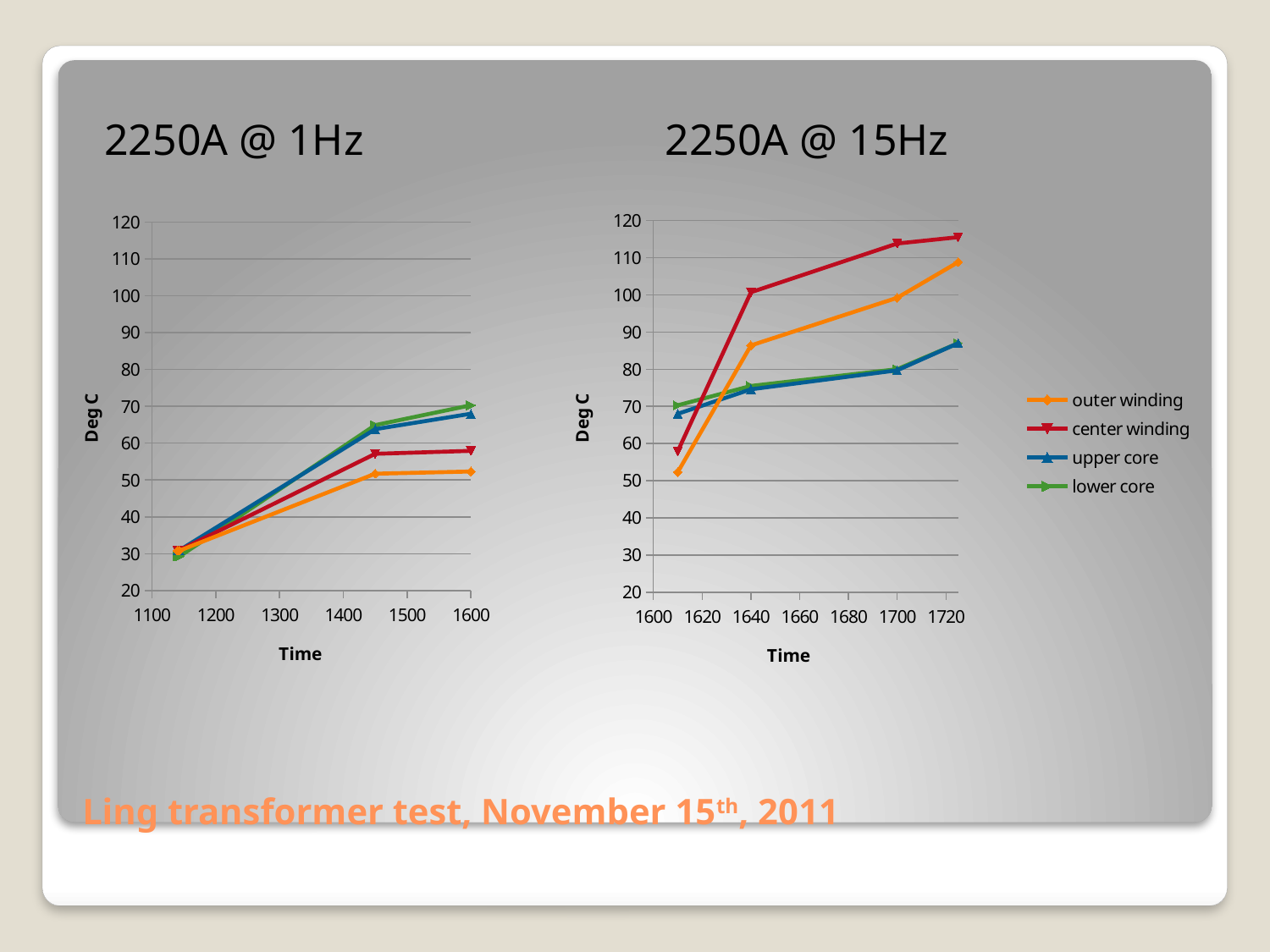
In the "2250A @ 1Hz" chart, at time 1600, is the lower core value or the outer winding value larger? lower core In the "2250A @ 15Hz" chart, how many data points does the center winding series have? 4 How many series does the legend list for the "2250A @ 15Hz" chart? 4 In the "2250A @ 15Hz" chart, which series has the highest value at time 1720? center winding In the "2250A @ 1Hz" chart, which series has the lowest value at time 1600? outer winding In the "2250A @ 15Hz" chart, is the outer winding value at time 1640 greater or less than 80? greater In the "2250A @ 1Hz" chart, is the outer winding value at time 1600 greater or less than 60? less In the "2250A @ 15Hz" chart, is the center winding value at time 1720 greater or less than 110? greater What kind of chart is the "2250A @ 1Hz" chart? line chart In the "2250A @ 15Hz" chart, does the outer winding series rise or fall as time increases? rise